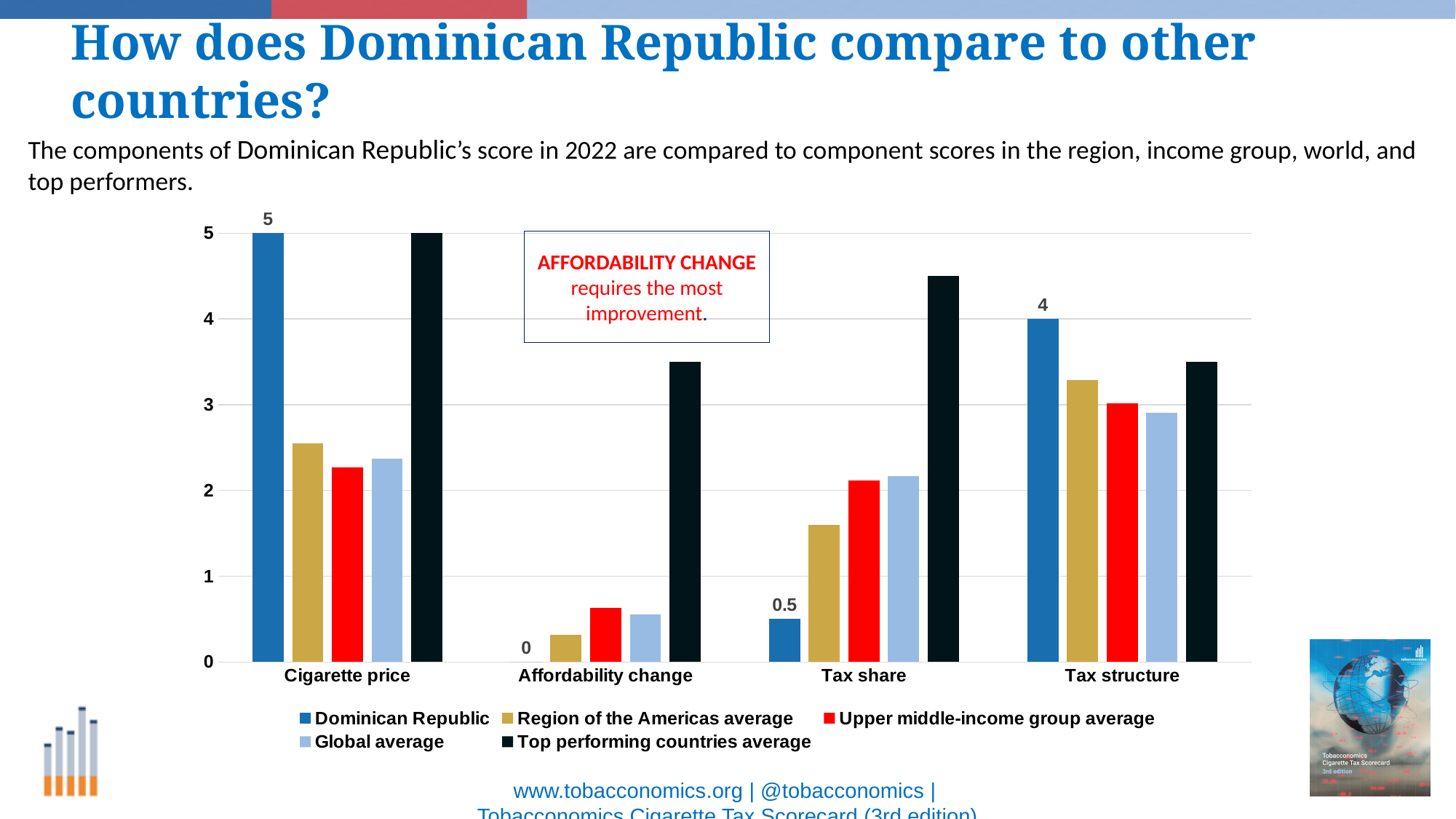
In which component does the Dominican Republic have its lowest score? Affordability change How many components are shown on the x axis? 4 What is the Dominican Republic's score for Tax structure? 4 What is the Dominican Republic's score for Affordability change? 0 How many series does the legend list? 5 What is the Dominican Republic's score for Tax share? 0.5 What kind of chart is shown on the slide? Bar chart In which component does the Dominican Republic have its highest score? Cigarette price Is the Top performing countries average for Tax share greater or less than 4? greater What is the difference between the Dominican Republic's Cigarette price score and its Tax structure score? 1 For Tax share, which is larger: the Region of the Americas average or the Upper middle-income group average? Upper middle-income group average What is the Dominican Republic's score for Cigarette price? 5